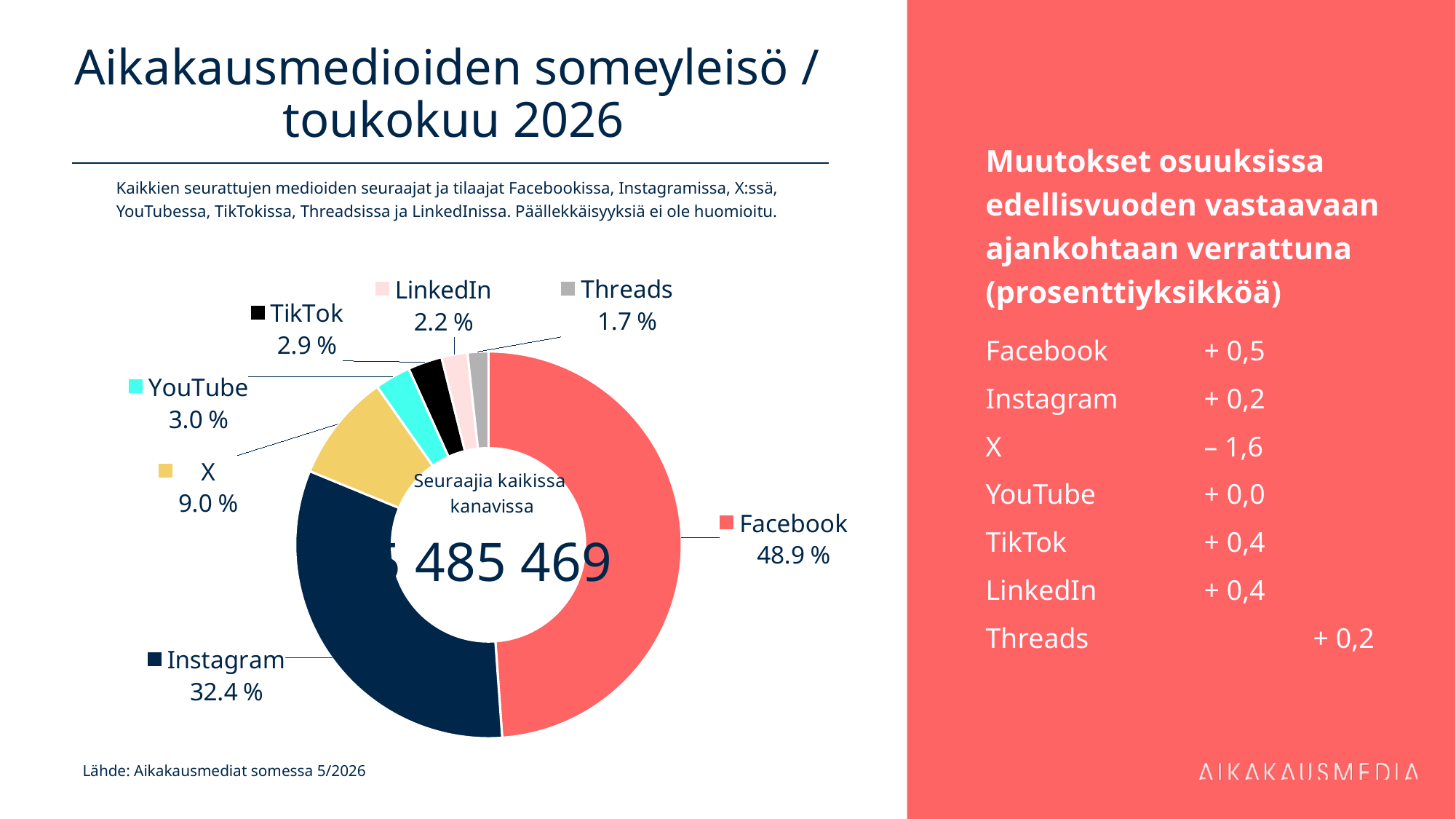
What share of the social media audience does Facebook have? 48.9 % What is the value shown for X in the donut chart? 9.0 % What colour is the Instagram slice in the donut chart? Dark navy blue What share of the social media audience does Instagram have? 32.4 % What kind of chart is shown on the slide? Donut (pie) chart Which channel has the smallest share in the donut chart? Threads What is the difference in percentage points between YouTube's and Threads' shares? 1.3 percentage points Which has a larger share, X or YouTube? X What is the value shown for LinkedIn in the donut chart? 2.2 % Which channel has the largest share in the donut chart? Facebook What is the difference in percentage points between Facebook's and Instagram's shares? 16.5 percentage points How many channels (slices) are shown in the donut chart? 7